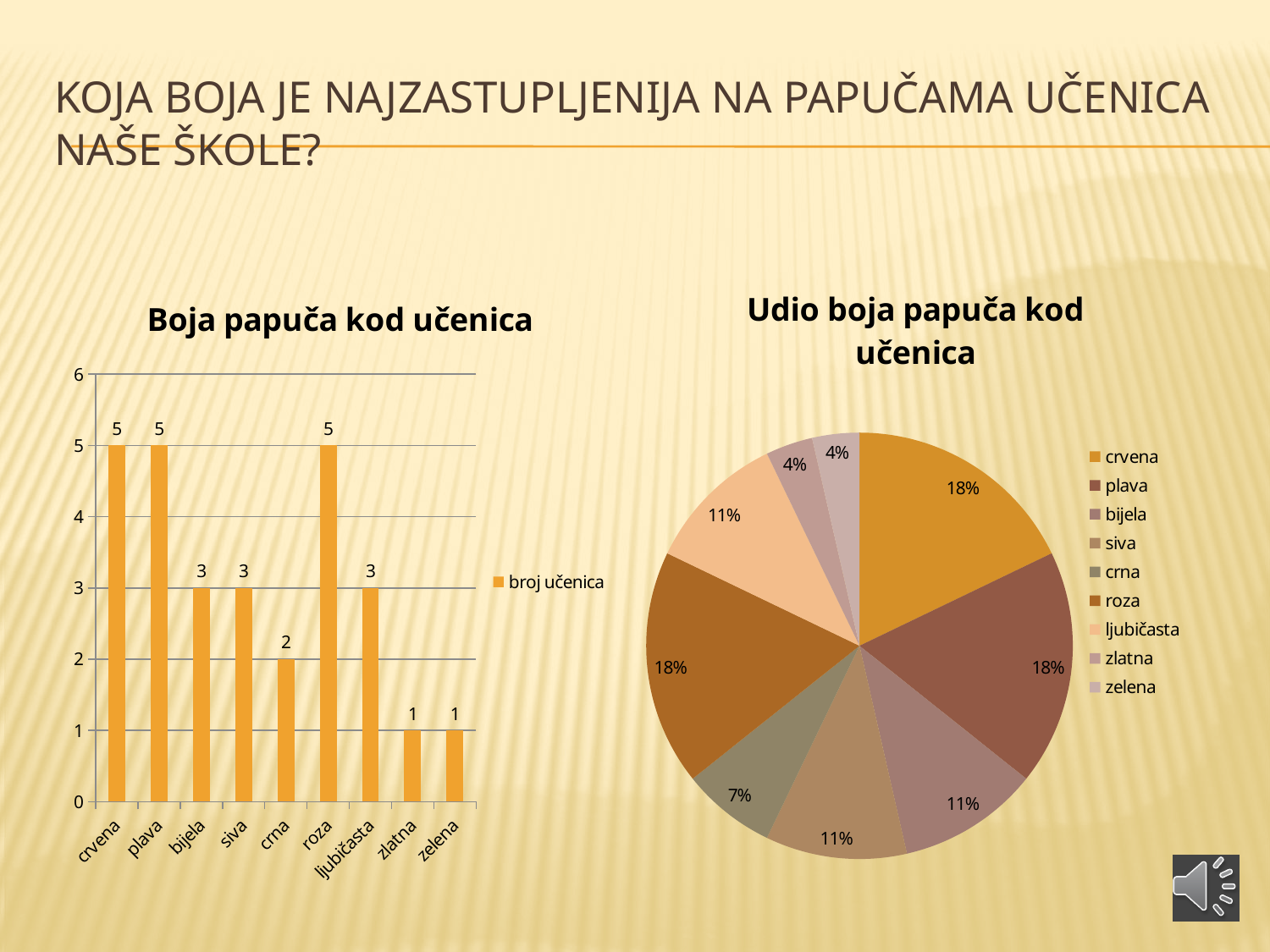
In the bar chart 'Boja papuča kod učenica', what is the difference between the values for plava and bijela? 2 In the bar chart 'Boja papuča kod učenica', which is larger, the value for siva or the value for zelena? siva What kind of chart is the chart on the left of the slide? bar chart How many categories are shown in the bar chart 'Boja papuča kod učenica'? 9 In the pie chart 'Udio boja papuča kod učenica', what share does crna have? 7% How many series does the legend of the bar chart 'Boja papuča kod učenica' list? 1 In the bar chart 'Boja papuča kod učenica', what is the value for roza? 5 In the pie chart 'Udio boja papuča kod učenica', what share does ljubičasta have? 11% How many entries does the legend of the pie chart 'Udio boja papuča kod učenica' list? 9 In the bar chart 'Boja papuča kod učenica', what is the value for crna? 2 In the bar chart 'Boja papuča kod učenica', what is the value for zlatna? 1 What is the name of the series in the legend of the bar chart 'Boja papuča kod učenica'? broj učenica